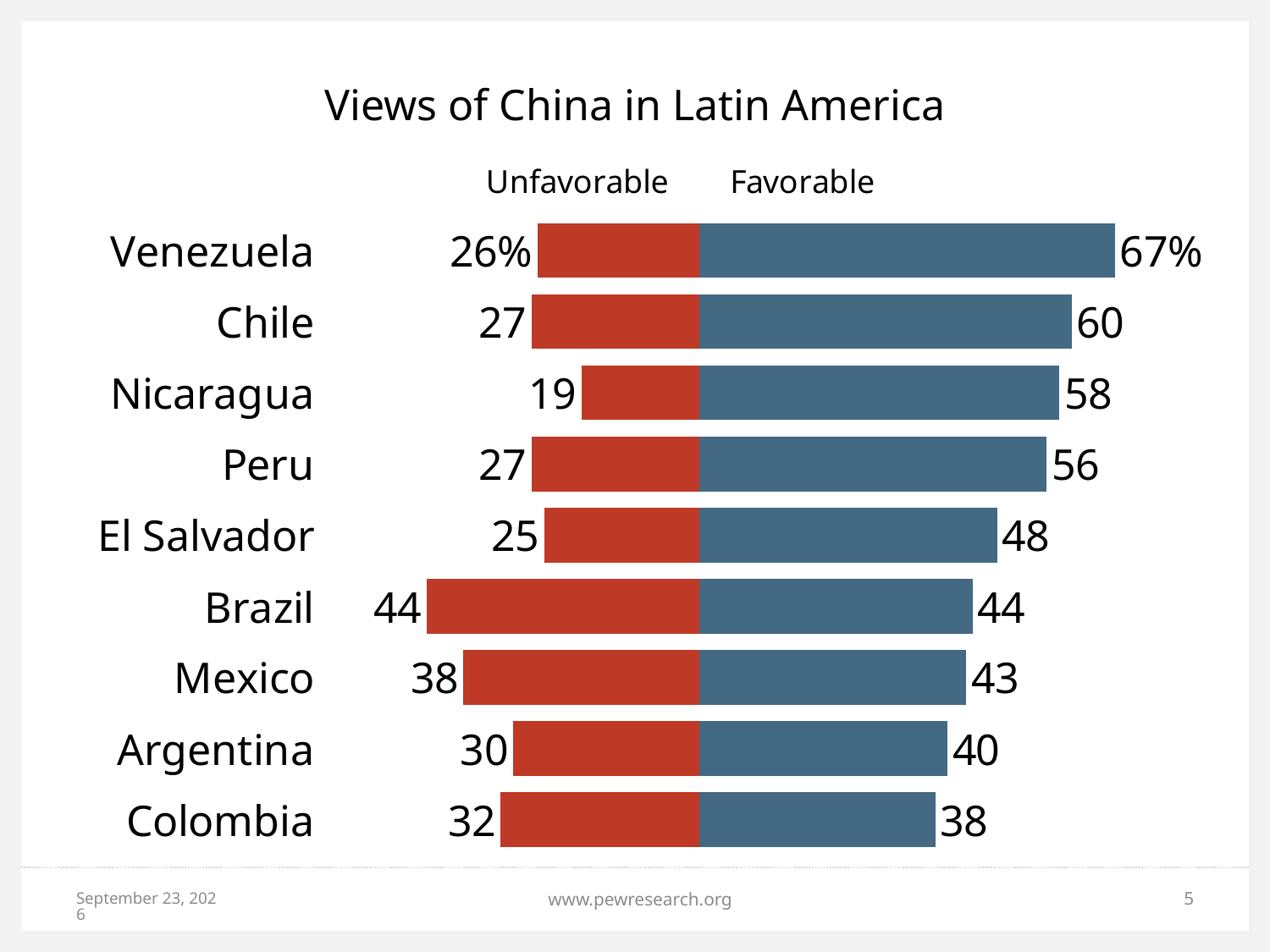
How many countries are shown in the chart? 9 Which colour represents the Unfavorable series? Red How many series does the chart show? 2 What is the difference between the Favorable and Unfavorable values for Chile? 33 Which country has the lowest Unfavorable value? Nicaragua What is the Unfavorable value for Brazil? 44 What is the Favorable value for Colombia? 38 Which country has the highest Favorable value? Venezuela Which is larger for Mexico, the Favorable value or the Unfavorable value? Favorable What is the title of the chart? Views of China in Latin America What kind of chart is this? Bar chart What is the Favorable value for Venezuela? 67%